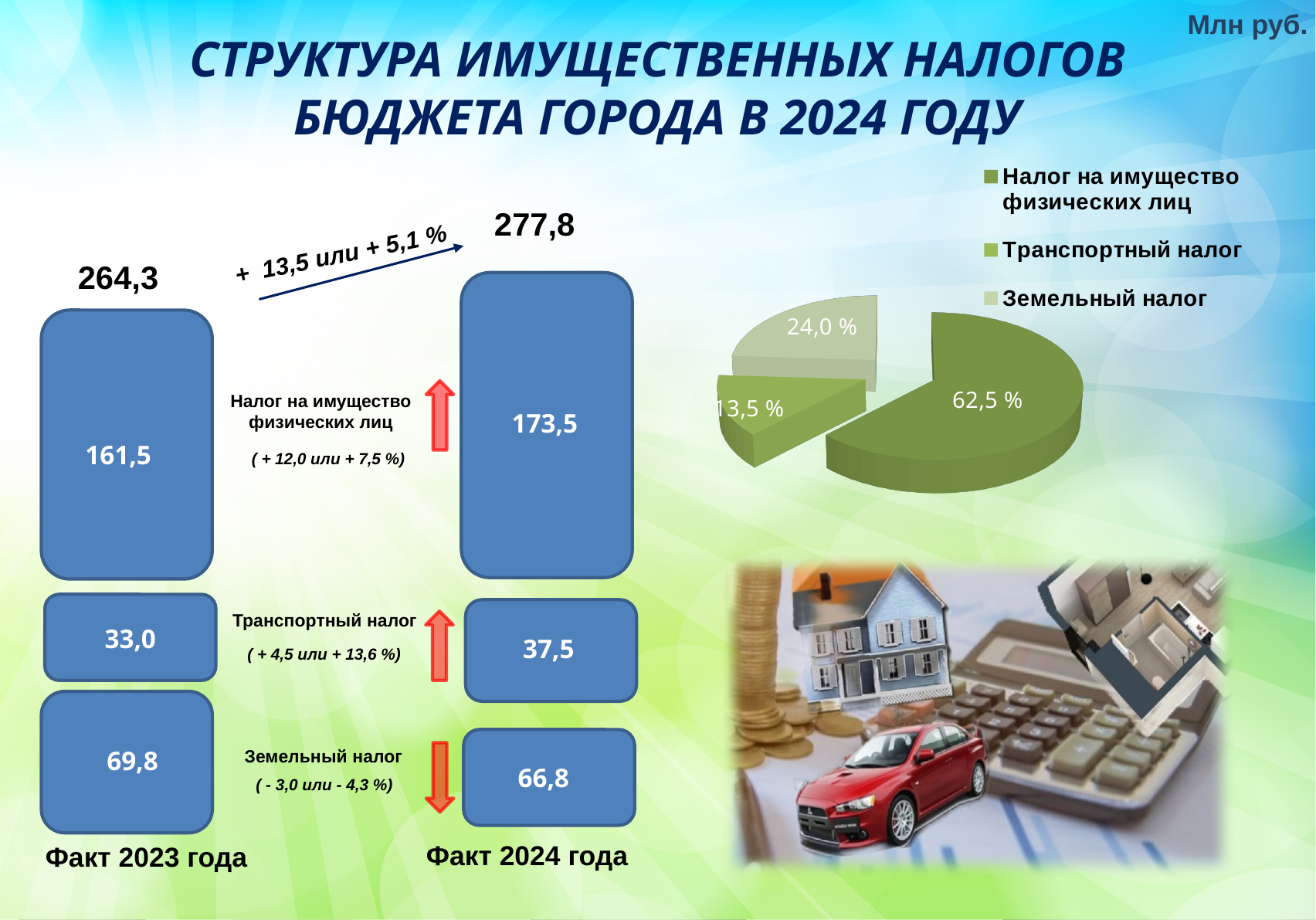
In the bar diagram on the left, what is the value of Земельный налог for Факт 2023 года? 69,8 In the pie chart, which tax has the largest share? Налог на имущество физических лиц How many entries does the legend of the pie chart list? 3 In the bar diagram on the left, which is larger: Земельный налог for Факт 2023 года or for Факт 2024 года? Факт 2023 года What kind of chart is shown on the right side of the slide? Pie chart In the bar diagram on the left, what is the value of Налог на имущество физических лиц for Факт 2024 года? 173,5 In the pie chart, what share does Налог на имущество физических лиц have? 62,5 % In the bar diagram on the left, what is the total for Факт 2024 года? 277,8 In the pie chart, what share does Транспортный налог have? 13,5 % In the bar diagram on the left, what is the difference between Транспортный налог in Факт 2024 года and Факт 2023 года? 4,5 In the pie chart, which tax has the smallest share? Транспортный налог In the pie chart, what share does Земельный налог have? 24,0 %